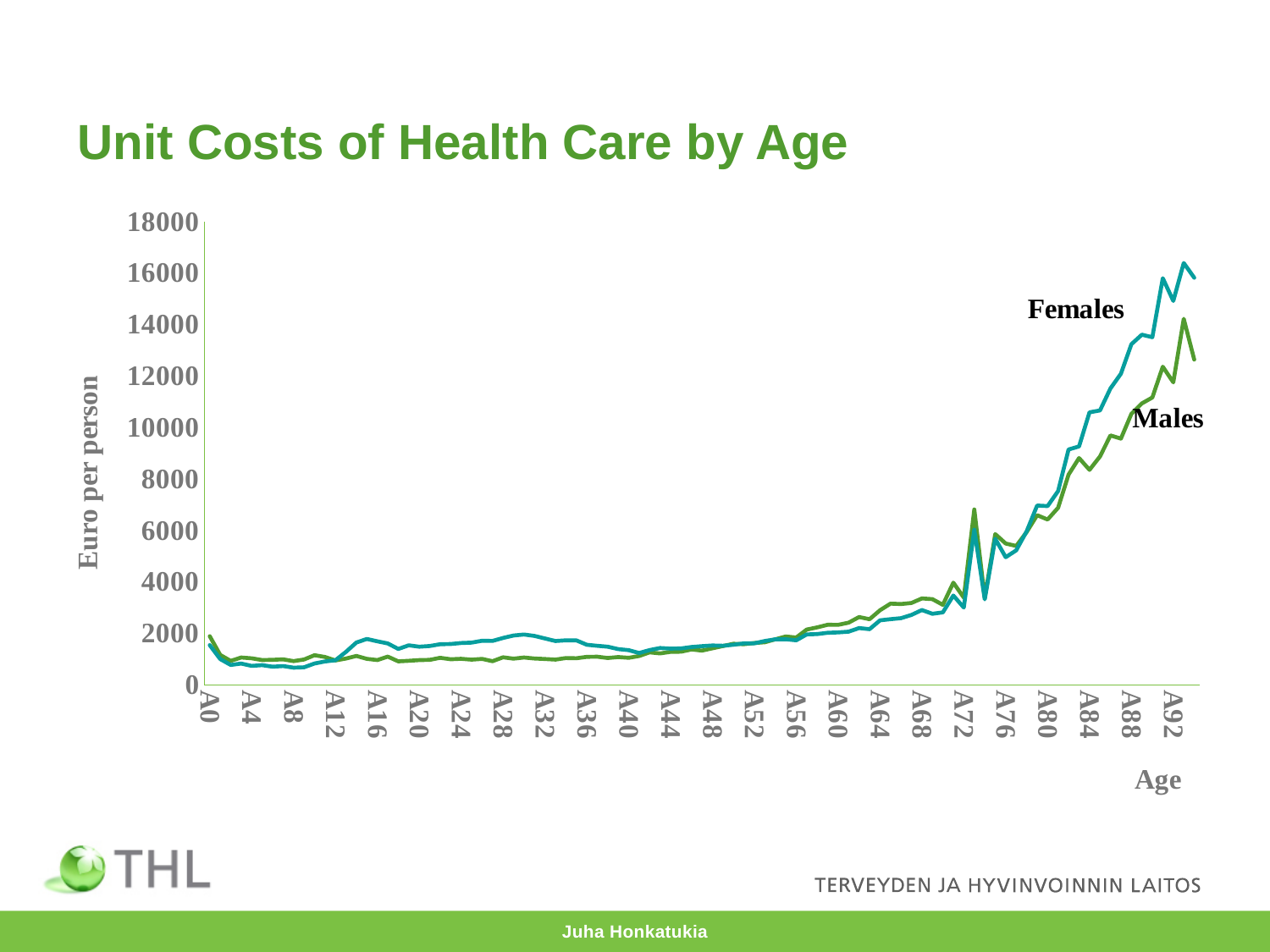
What is the title of the chart on the slide? Unit Costs of Health Care by Age At A16, which series has the higher value, Females or Males? Females Is the value for Females at A92 greater or less than 14000? greater Is the value for Females at A40 greater or less than 2000? less What is the label of the vertical axis? Euro per person What kind of chart is shown on the slide? line chart At A88, which series has the higher value, Females or Males? Females Is the value for Males at A88 greater or less than 8000? greater Which series reaches the highest value on the chart? Females Overall, do the values rise or fall as age increases along the x axis? rise How many series are plotted on the chart? 2